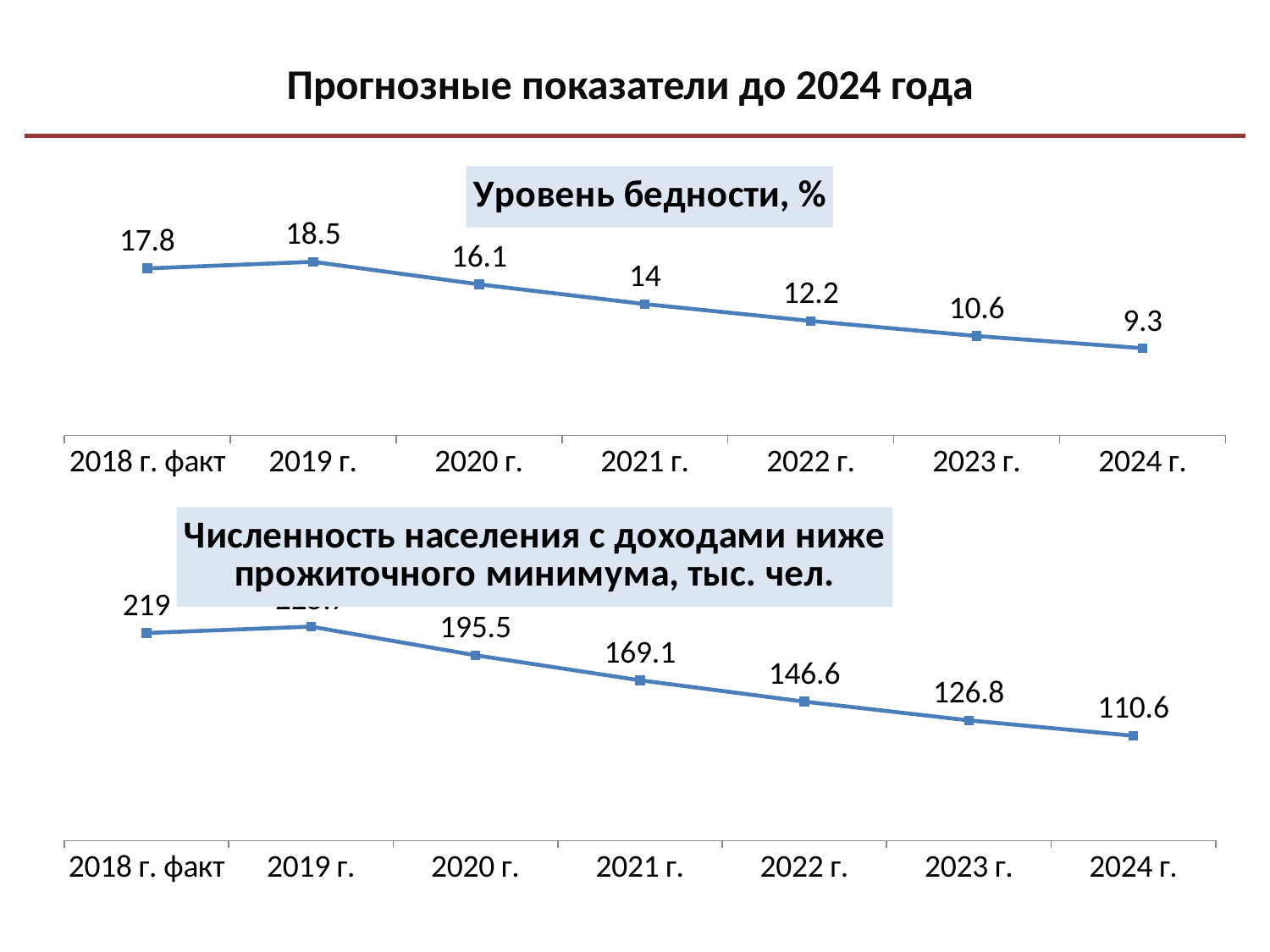
In the bottom chart (Численность населения с доходами ниже прожиточного минимума, тыс. чел.), which is larger: the value for 2020 г. or the value for 2023 г.? 2020 г. In the chart titled "Уровень бедности, %", how many data points are plotted? 7 In the chart titled "Уровень бедности, %", do the values rise or fall from 2019 г. to 2024 г.? fall In the chart titled "Уровень бедности, %", which year has the lowest value? 2024 г. In the chart titled "Уровень бедности, %", what is the value for 2021 г.? 14 In the bottom chart (Численность населения с доходами ниже прожиточного минимума, тыс. чел.), what is the value for 2022 г.? 146.6 In the bottom chart (Численность населения с доходами ниже прожиточного минимума, тыс. чел.), what is the difference between the values for 2018 г. факт and 2024 г.? 108.4 In the chart titled "Уровень бедности, %", what is the value for 2018 г. факт? 17.8 In the bottom chart (Численность населения с доходами ниже прожиточного минимума, тыс. чел.), what is the value for 2024 г.? 110.6 What type of chart is the top chart titled "Уровень бедности, %"? line chart In the chart titled "Уровень бедности, %", what is the difference between the values for 2019 г. and 2024 г.? 9.2 In the chart titled "Уровень бедности, %", which year has the highest value? 2019 г.